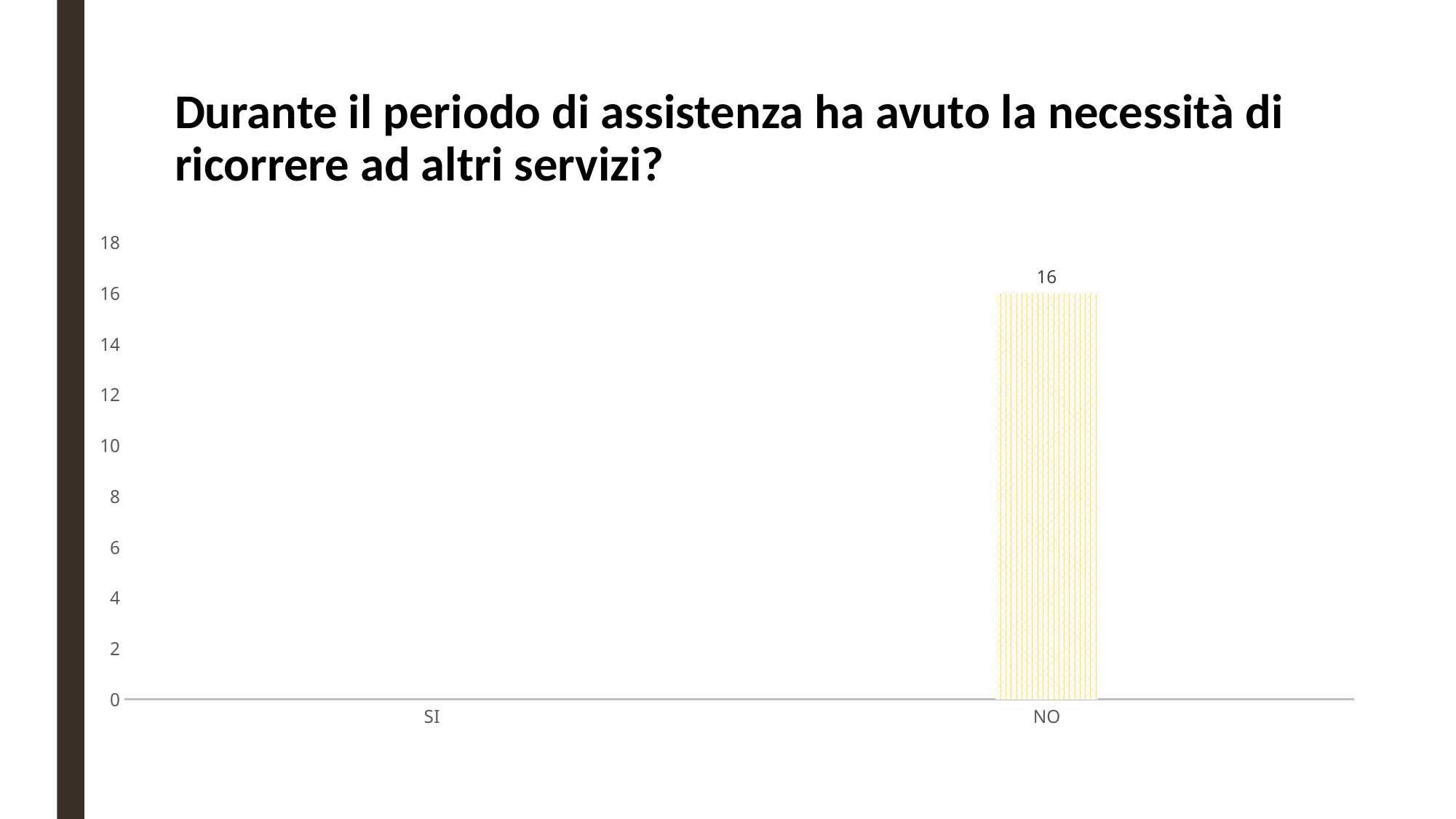
What is the title of the slide? Durante il periodo di assistenza ha avuto la necessità di ricorrere ad altri servizi? Which is larger, the value for SI or the value for NO? NO What kind of chart is shown on the slide? bar chart Which category has the highest value? NO How many categories are shown on the x axis? 2 Is the value for NO greater or less than 10? greater Which category has the lowest value? SI What is the value for NO? 16 What is the highest tick value shown on the y axis? 18